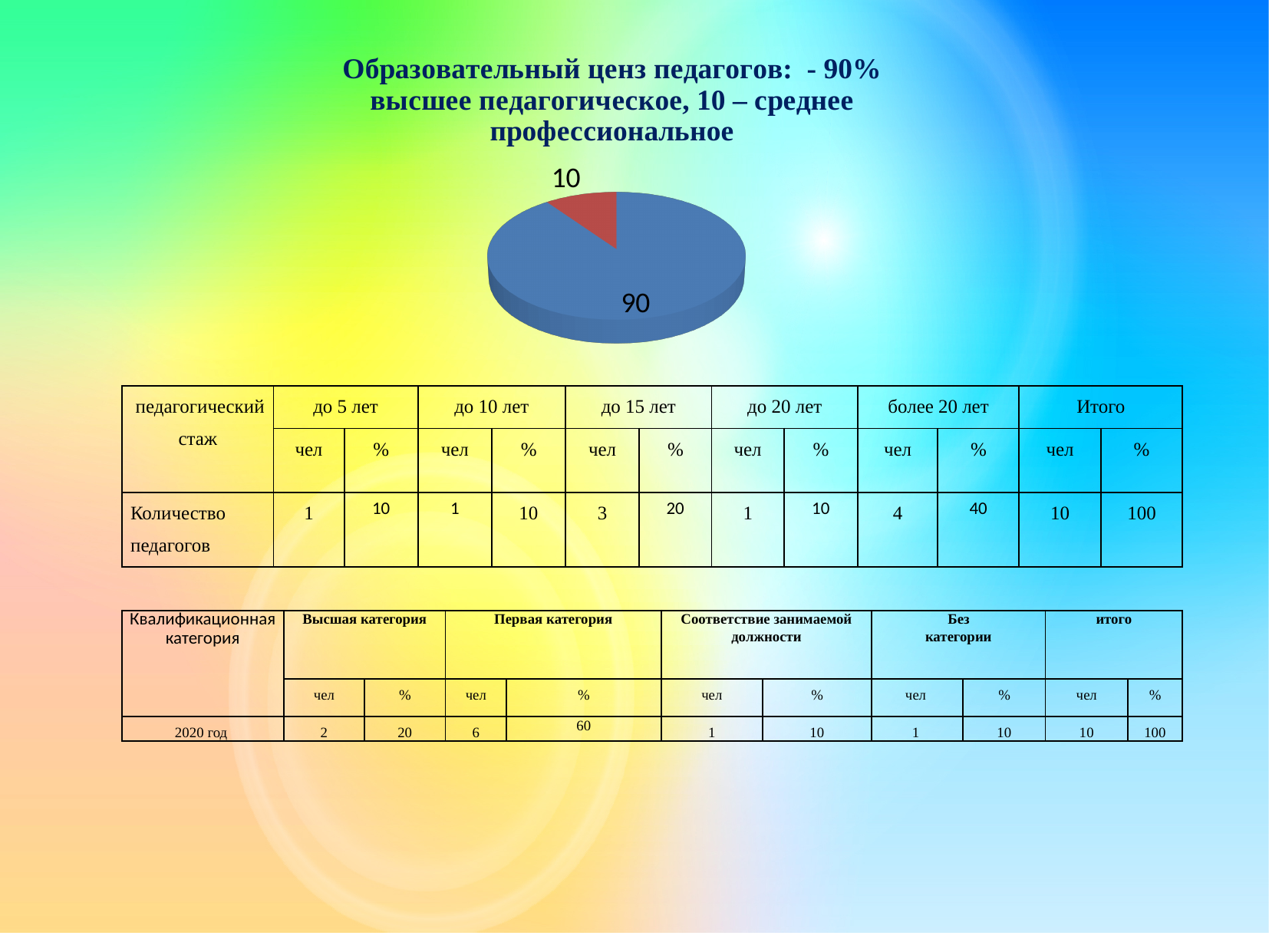
How many slices does the pie chart have? 2 What colour is the slice labelled 90 in the pie chart? blue What is the smallest value shown in the pie chart? 10 What value is labelled on the larger slice of the pie chart? 90 What kind of chart is shown on the slide? pie chart Which slice is larger in the pie chart, the one labelled 90 or the one labelled 10? 90 What value is labelled on the smaller slice of the pie chart? 10 According to the slide title, what does the 90 slice of the pie chart represent? высшее педагогическое What share of the pie does the slice labelled 90 represent? 90% What colour is the slice labelled 10 in the pie chart? red What is the largest value shown in the pie chart? 90 What is the difference between the two slice values in the pie chart? 80